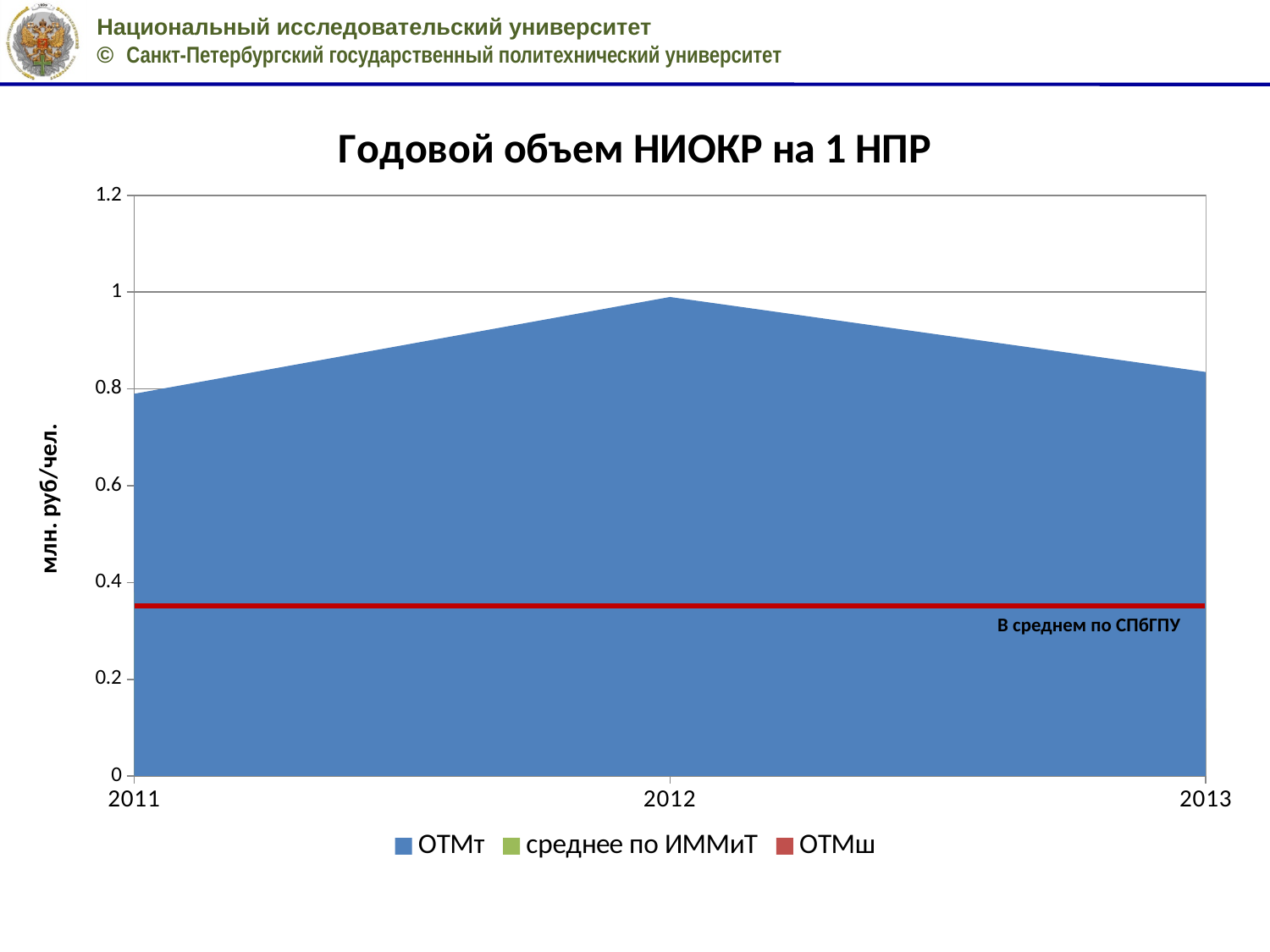
Is the ОТМт value for 2012 greater or less than 0.8? greater What kind of chart is shown on the slide? area chart Is the ОТМт value for 2011 greater or less than 1? less Is the value of the red line labelled 'В среднем по СПбГПУ' greater or less than 0.4? less In which year is the ОТМт value lowest? 2011 How many years are shown on the x axis? 3 How many series does the legend list? 3 What unit is shown on the vertical axis label? млн. руб/чел. What is the title of the chart? Годовой объем НИОКР на 1 НПР In which year is the ОТМт value highest? 2012 How does the ОТМт value change from 2011 to 2013? rises from 2011 to 2012, then falls in 2013 Which year has the larger ОТМт value, 2012 or 2013? 2012